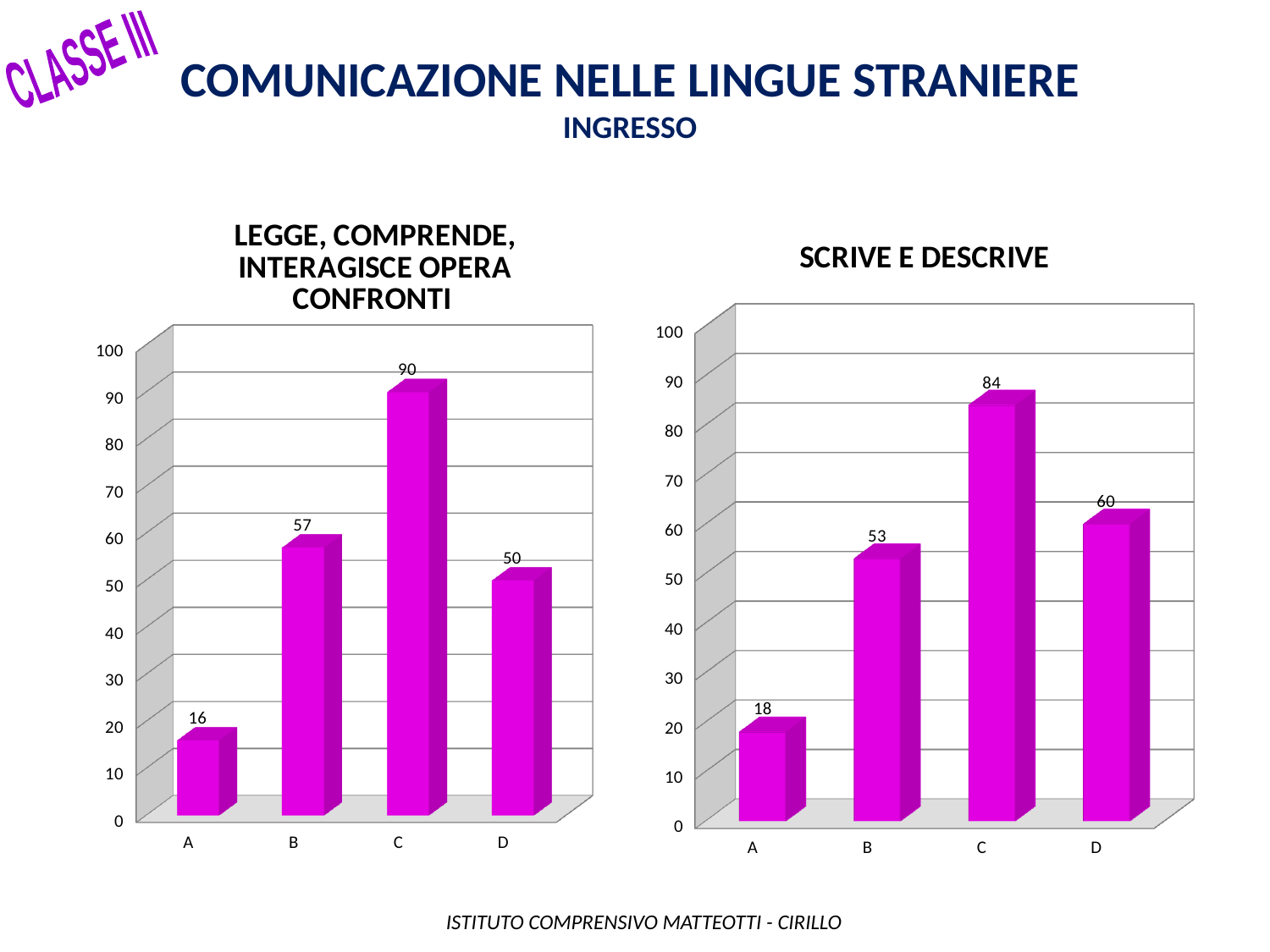
How many categories are shown in the 'SCRIVE E DESCRIVE' chart? 4 In the 'LEGGE, COMPRENDE, INTERAGISCE OPERA CONFRONTI' chart, what is the value for category C? 90 In the 'LEGGE, COMPRENDE, INTERAGISCE OPERA CONFRONTI' chart, what is the difference between the values for B and D? 7 In the 'SCRIVE E DESCRIVE' chart, what is the value for category A? 18 In the 'LEGGE, COMPRENDE, INTERAGISCE OPERA CONFRONTI' chart, which category has the lowest value? A In the 'SCRIVE E DESCRIVE' chart, what is the value for category B? 53 What kind of chart is the 'LEGGE, COMPRENDE, INTERAGISCE OPERA CONFRONTI' chart? Bar chart In the 'LEGGE, COMPRENDE, INTERAGISCE OPERA CONFRONTI' chart, is the value for B greater or less than 50? greater In the 'SCRIVE E DESCRIVE' chart, what is the difference between the values for C and D? 24 What is the title of the chart on the right side of the slide? SCRIVE E DESCRIVE In the 'SCRIVE E DESCRIVE' chart, which is larger, the value for B or the value for D? D In the 'SCRIVE E DESCRIVE' chart, which category has the highest value? C